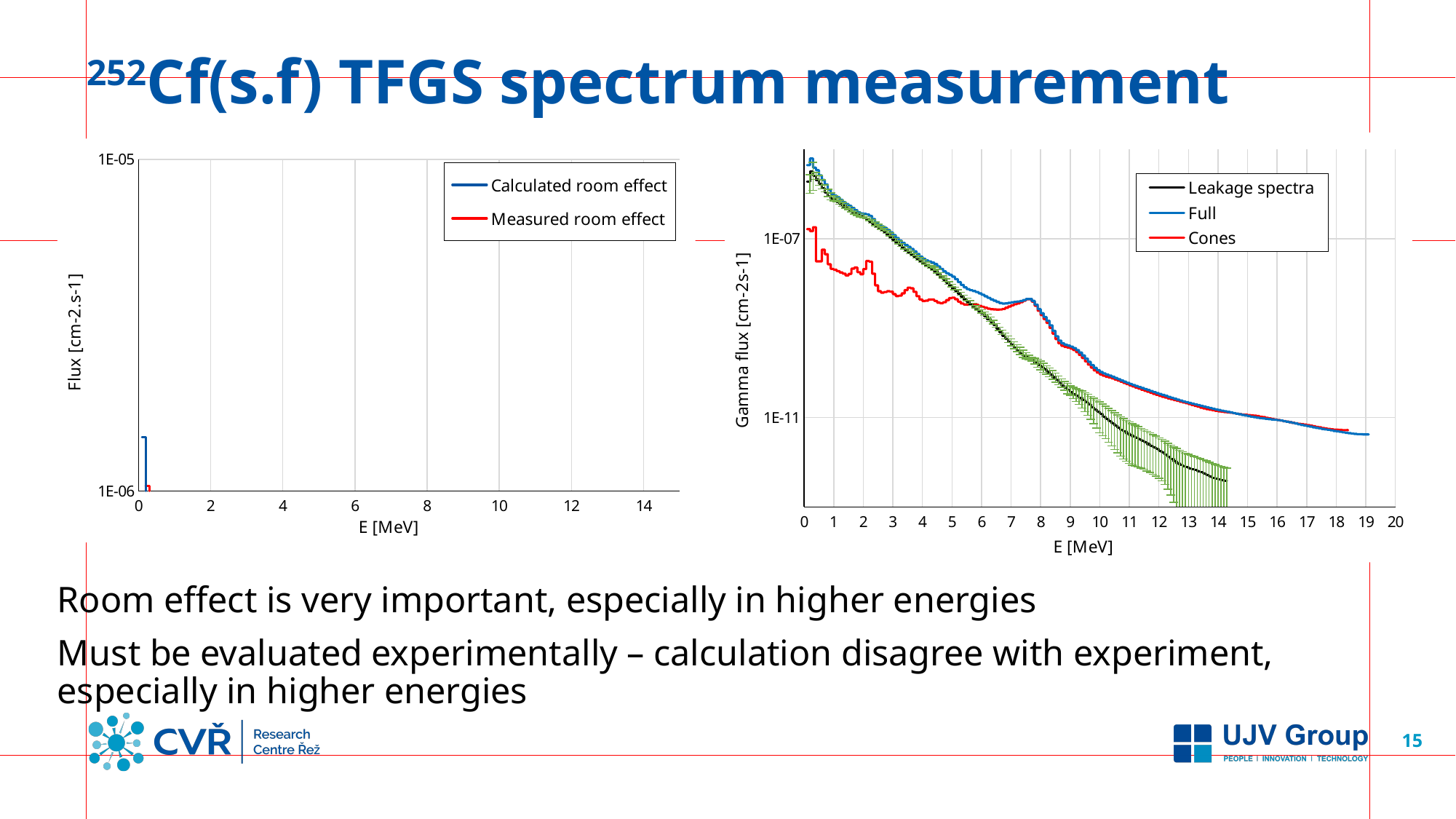
In the right chart, is the Leakage spectra value at 14 MeV greater or less than 1E-11? less In the right chart, is the Cones value at 2 MeV greater or less than 1E-07? less In the right chart, how many series does the legend list? 3 In the right chart, which series is higher at 12 MeV, Full or Leakage spectra? Full In the right chart, do the Full series values rise or fall as E [MeV] increases? fall What kind of chart is the right chart? line chart In the right chart, is the Full value at 1 MeV greater or less than 1E-07? greater In the left chart, how many series does the legend list? 2 In the right chart, which series is higher at 2 MeV, Full or Cones? Full In the left chart, which legend entry is drawn in red? Measured room effect What is the y-axis label of the right chart? Gamma flux [cm-2s-1]